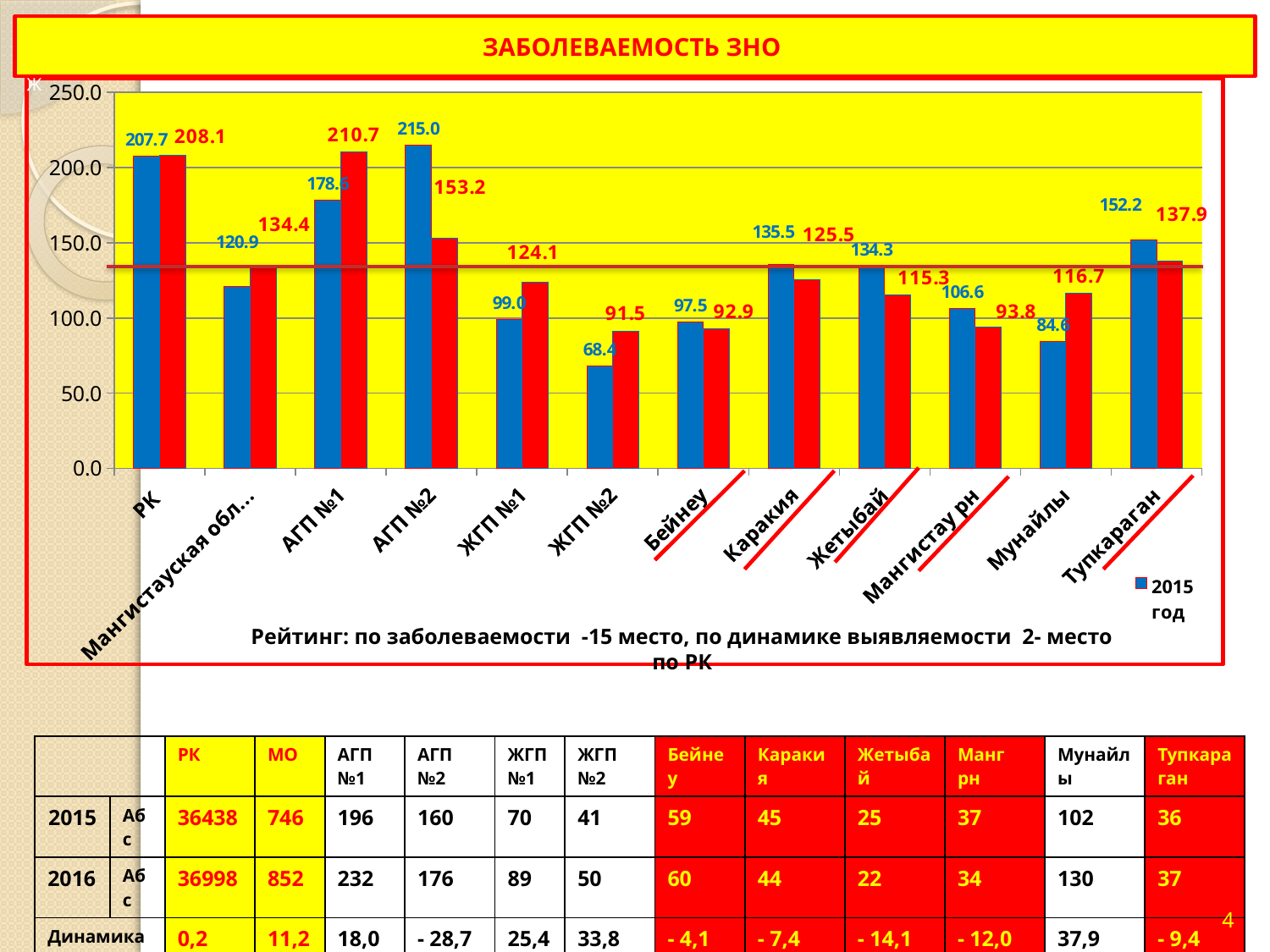
Which category has the highest 2015 год (blue) value? АГП №2 For Тупкараган, which is larger: the blue bar or the red bar? the blue bar What is the value of the red bar for ЖГП №1? 124.1 Which category has the lowest 2015 год (blue) value? ЖГП №2 For АГП №2, how much higher is the blue bar than the red bar? 61.8 What type of chart is shown on the slide? bar chart Is the red-bar value for Бейнеу greater or less than 100? less How many categories are shown on the x axis of the chart? 12 For Мунайлы, what is the difference between the red bar (116.7) and the blue bar (84.6)? 32.1 What is the 2015 год (blue) value for АГП №2? 215.0 Which category has the highest red-bar value? АГП №1 What is the value of the red bar for РК? 208.1